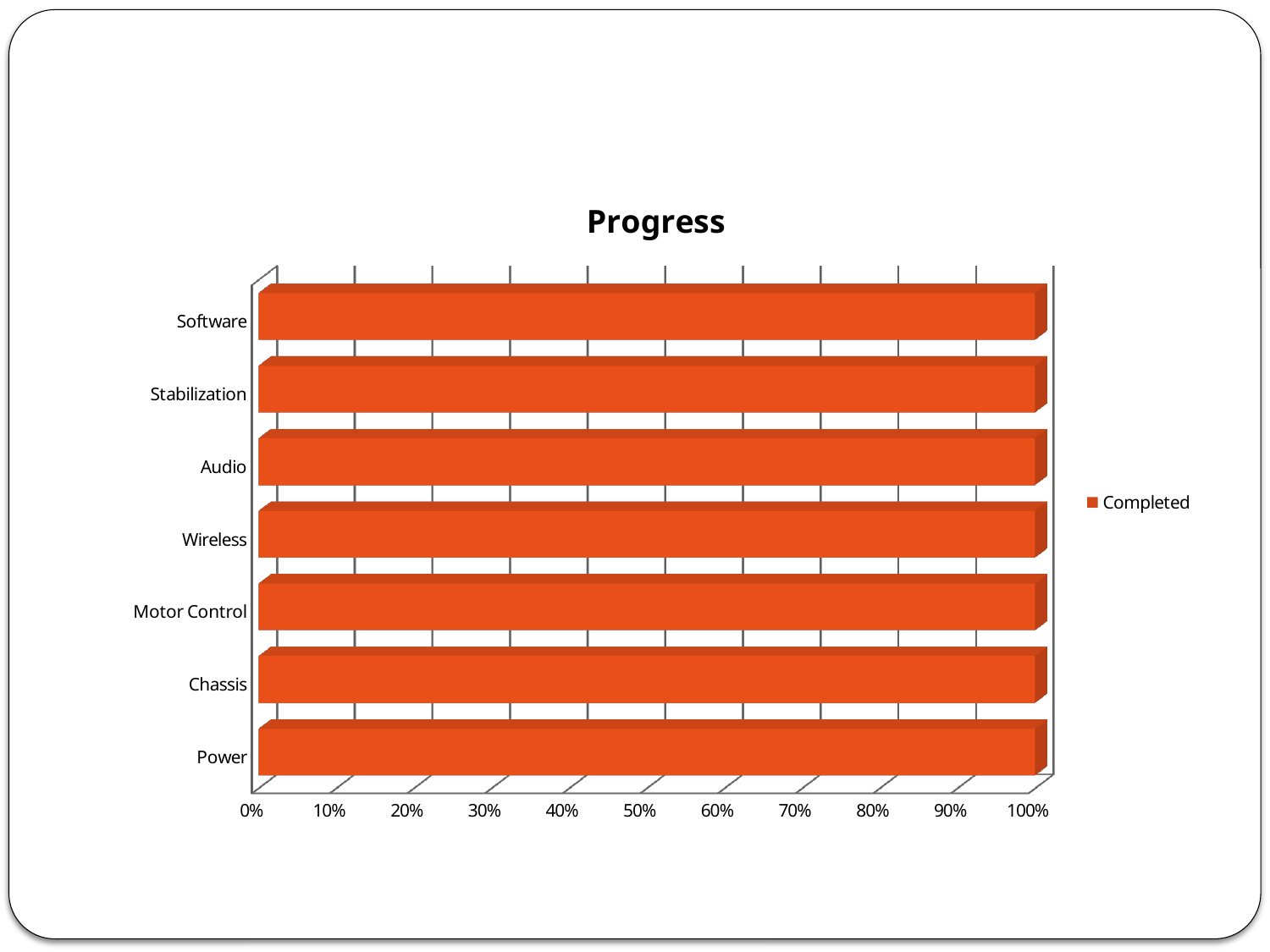
Is the value for Chassis greater or less than 90%? greater How many series does the legend list? 1 Is the value for Wireless greater or less than 50%? greater What kind of chart is shown on the slide? bar chart What is the name of the series shown in the legend? Completed What is the title of the chart? Progress What is the highest value shown on the horizontal axis? 100% How many categories are plotted in the chart? 7